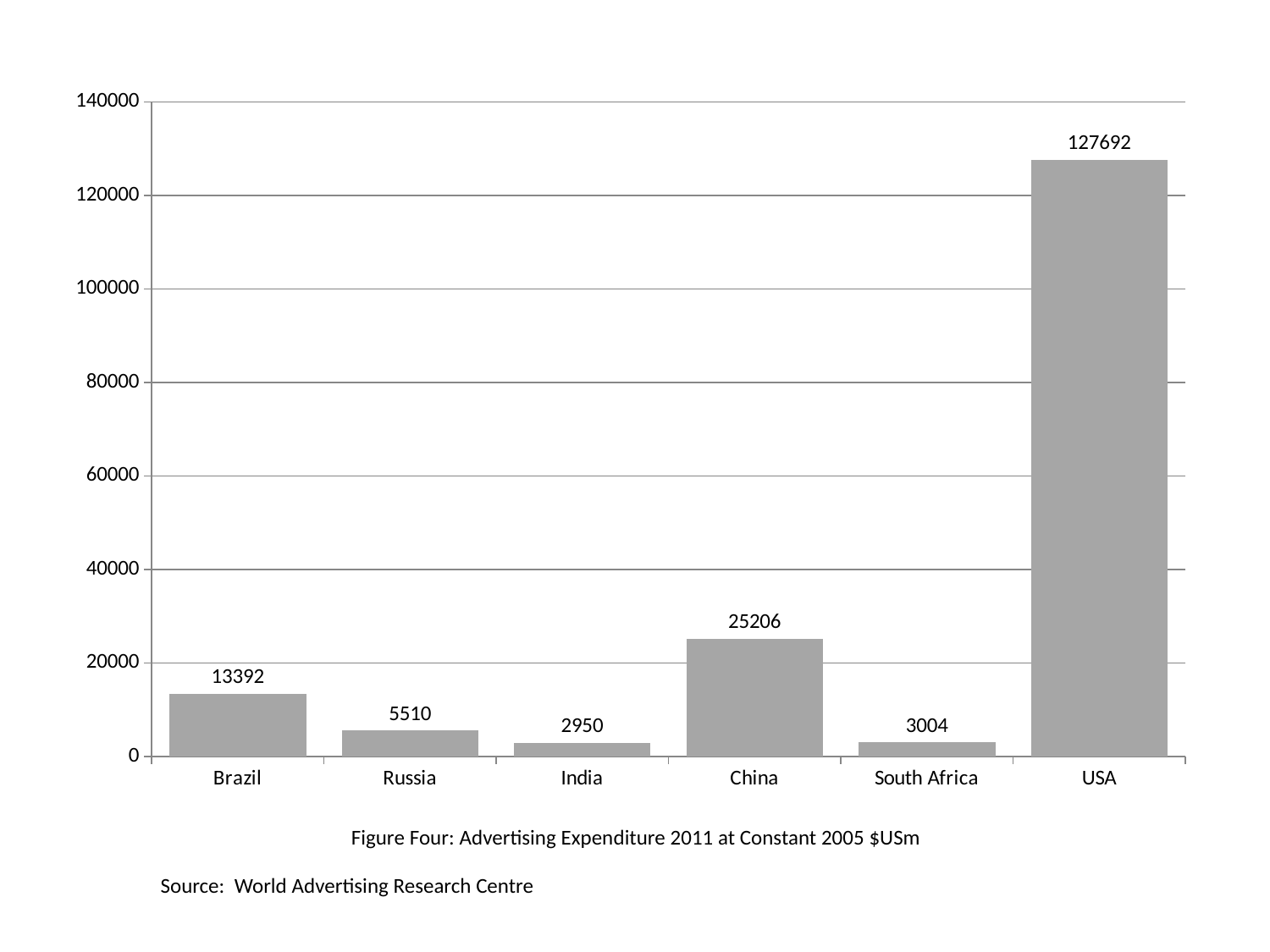
What is the advertising expenditure value for Brazil? 13392 Which country has the lowest advertising expenditure? India What is the source cited for the chart? World Advertising Research Centre Which is larger, the value for Russia or the value for South Africa? Russia What is the difference between the values for Brazil and Russia? 7882 Which country has the highest advertising expenditure? USA How many countries are shown on the chart? 6 Is the value for China greater or less than 20000? greater What is the advertising expenditure value for South Africa? 3004 What is the advertising expenditure value for China? 25206 What kind of chart is shown on the slide? bar chart What is the difference between the values for USA and China? 102486